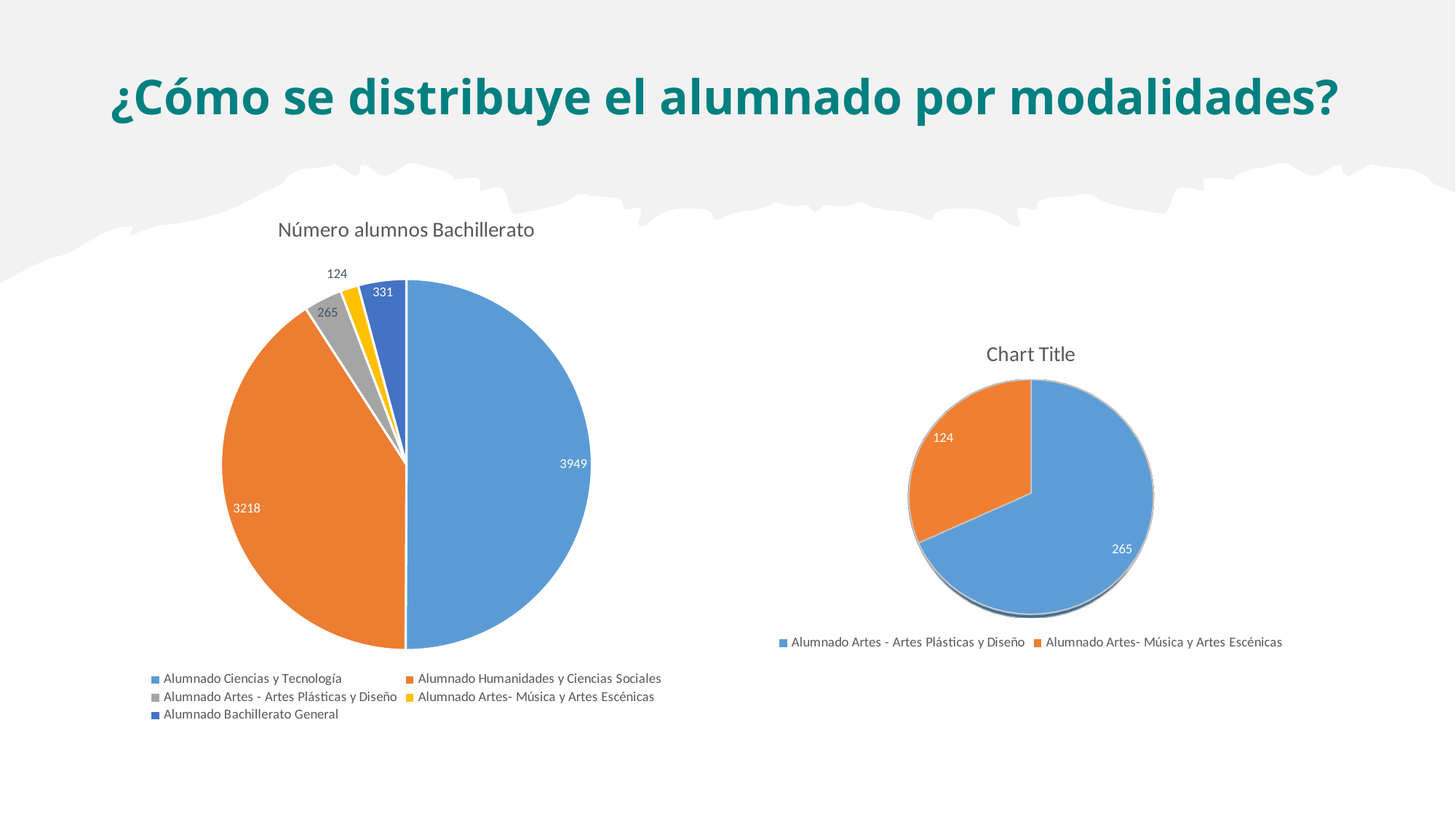
In the chart titled 'Número alumnos Bachillerato', what is the value for Alumnado Bachillerato General? 331 In the chart titled 'Número alumnos Bachillerato', what is the value for Alumnado Ciencias y Tecnología? 3949 What kind of chart is the one titled 'Número alumnos Bachillerato'? Pie chart In the chart titled 'Número alumnos Bachillerato', which category has the largest slice? Alumnado Ciencias y Tecnología In the chart titled 'Chart Title' on the right, how many entries does the legend list? 2 In the chart titled 'Chart Title' on the right, what is the value for Alumnado Artes- Música y Artes Escénicas? 124 In the chart titled 'Número alumnos Bachillerato', which category has the smallest slice? Alumnado Artes- Música y Artes Escénicas In the chart titled 'Número alumnos Bachillerato', how many categories are shown? 5 In the chart titled 'Número alumnos Bachillerato', what is the value for Alumnado Humanidades y Ciencias Sociales? 3218 In the chart titled 'Chart Title' on the right, which is larger: Alumnado Artes - Artes Plásticas y Diseño or Alumnado Artes- Música y Artes Escénicas? Alumnado Artes - Artes Plásticas y Diseño In the chart titled 'Chart Title' on the right, what is the difference between the two slices? 141 In the chart titled 'Número alumnos Bachillerato', what is the difference between Alumnado Ciencias y Tecnología and Alumnado Humanidades y Ciencias Sociales? 731